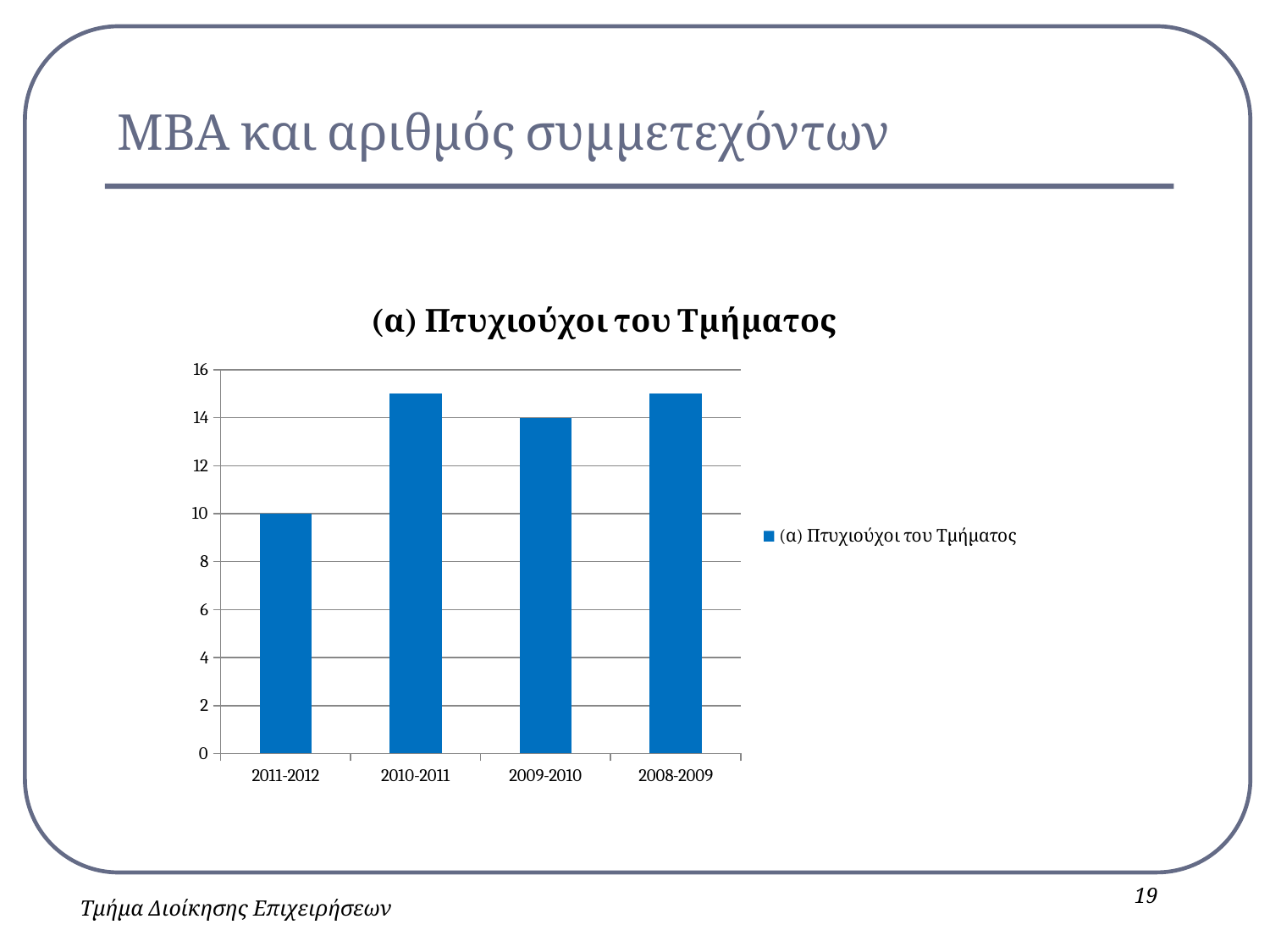
Is the value for 2008-2009 greater or less than 16? less Is the value for 2010-2011 greater or less than 14? greater Which is larger, the value for 2011-2012 or the value for 2009-2010? 2009-2010 Which category has the lowest value? 2011-2012 What is the difference between the value for 2009-2010 and the value for 2011-2012? 4 What is the value for 2009-2010? 14 What is the title of the chart? (α) Πτυχιούχοι του Τμήματος How many series does the legend list? 1 What is the value for 2011-2012? 10 How many categories are shown on the x axis of the chart? 4 What type of chart is shown on the slide? bar chart What is the legend entry shown next to the chart? (α) Πτυχιούχοι του Τμήματος